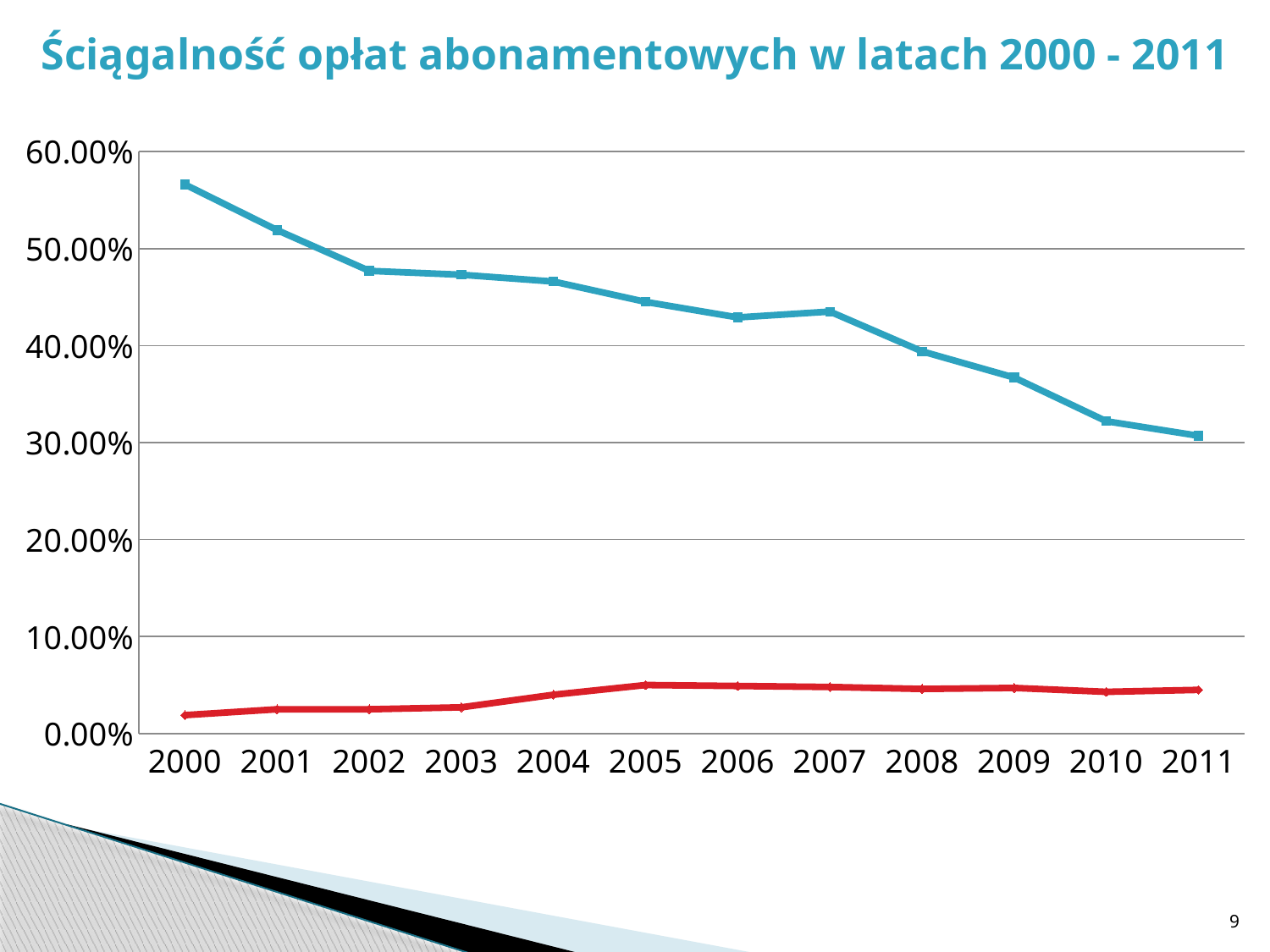
In which year is the red line at its lowest value? 2000 Which line has the higher value in 2011, the blue line or the red line? the blue line What kind of chart is shown on the slide? line chart How many years are shown on the x axis of the chart? 12 What is the title of the chart? Ściągalność opłat abonamentowych w latach 2000 - 2011 Is the value of the blue line in 2002 greater or less than 50.00%? less Is the value of the blue line in 2006 greater or less than 40.00%? greater In which year is the blue line at its highest value? 2000 Is the value of the blue line in 2000 greater or less than 50.00%? greater In which year is the blue line at its lowest value? 2011 How many lines are plotted on the chart? 2 Does the blue line rise or fall from 2000 to 2011? fall